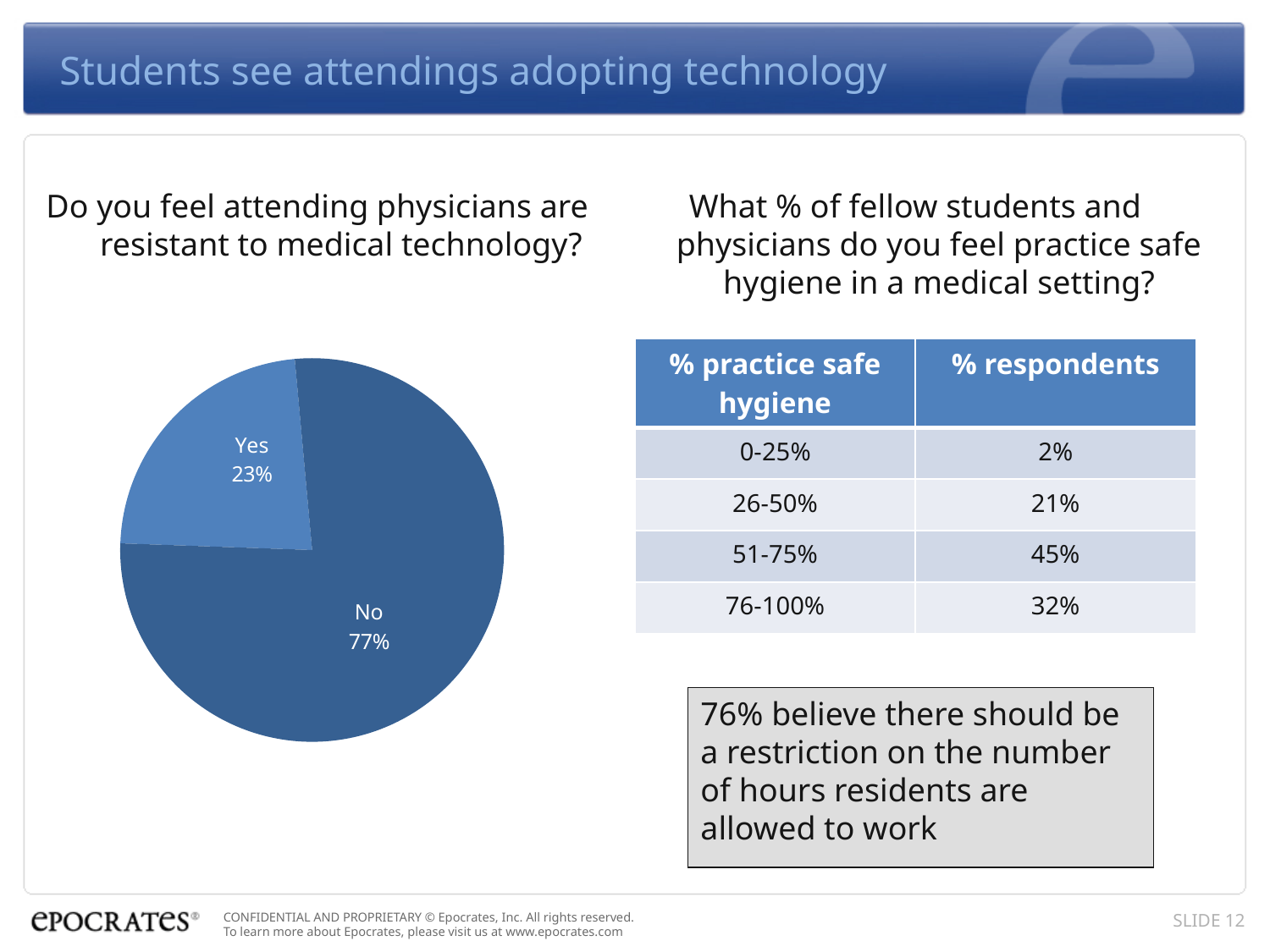
What kind of chart is shown on the slide? pie chart In the pie chart, what share of respondents answered "Yes"? 23% Which slice of the pie chart is the largest? No What is the difference in percentage points between the "No" and "Yes" slices of the pie chart? 54 What question does the pie chart answer? Do you feel attending physicians are resistant to medical technology? Is the "Yes" slice of the pie chart greater or less than 25%? less Is the "No" slice of the pie chart greater or less than 75%? greater How many slices does the pie chart have? 2 Which slice of the pie chart is the smallest? Yes In the pie chart, what share of respondents answered "No"? 77% What is the total of the two slices shown in the pie chart? 100% In the pie chart, which is larger: the "Yes" slice or the "No" slice? No